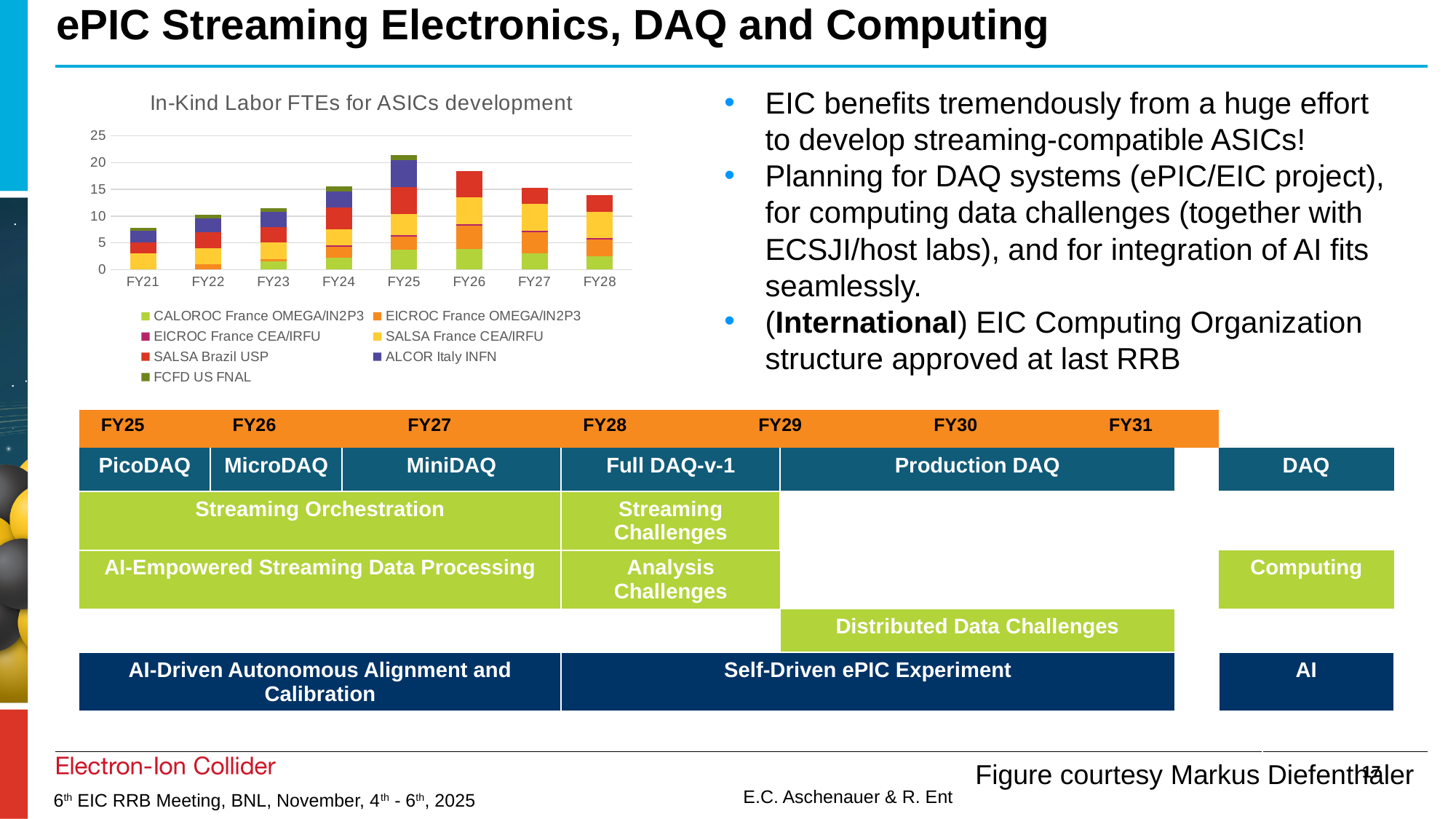
In the "In-Kind Labor FTEs for ASICs development" chart, which series is shown in light green in the legend? CALOROC France OMEGA/IN2P3 In the "In-Kind Labor FTEs for ASICs development" chart, which fiscal year has the lowest total stacked bar? FY21 How many fiscal years are shown on the x axis of the "In-Kind Labor FTEs for ASICs development" chart? 8 In the "In-Kind Labor FTEs for ASICs development" chart, which has the larger total, FY25 or FY26? FY25 In the "In-Kind Labor FTEs for ASICs development" chart, do the total FTEs rise or fall from FY21 to FY25? rise In the "In-Kind Labor FTEs for ASICs development" chart, is the total for FY25 greater or less than 20? greater In the "In-Kind Labor FTEs for ASICs development" chart, is the total for FY21 greater or less than 10? less In the "In-Kind Labor FTEs for ASICs development" chart, which fiscal year has the highest total stacked bar? FY25 What type of chart is "In-Kind Labor FTEs for ASICs development"? Stacked bar chart In the "In-Kind Labor FTEs for ASICs development" chart, is the total for FY28 greater or less than 15? less How many series does the legend of the "In-Kind Labor FTEs for ASICs development" chart list? 7